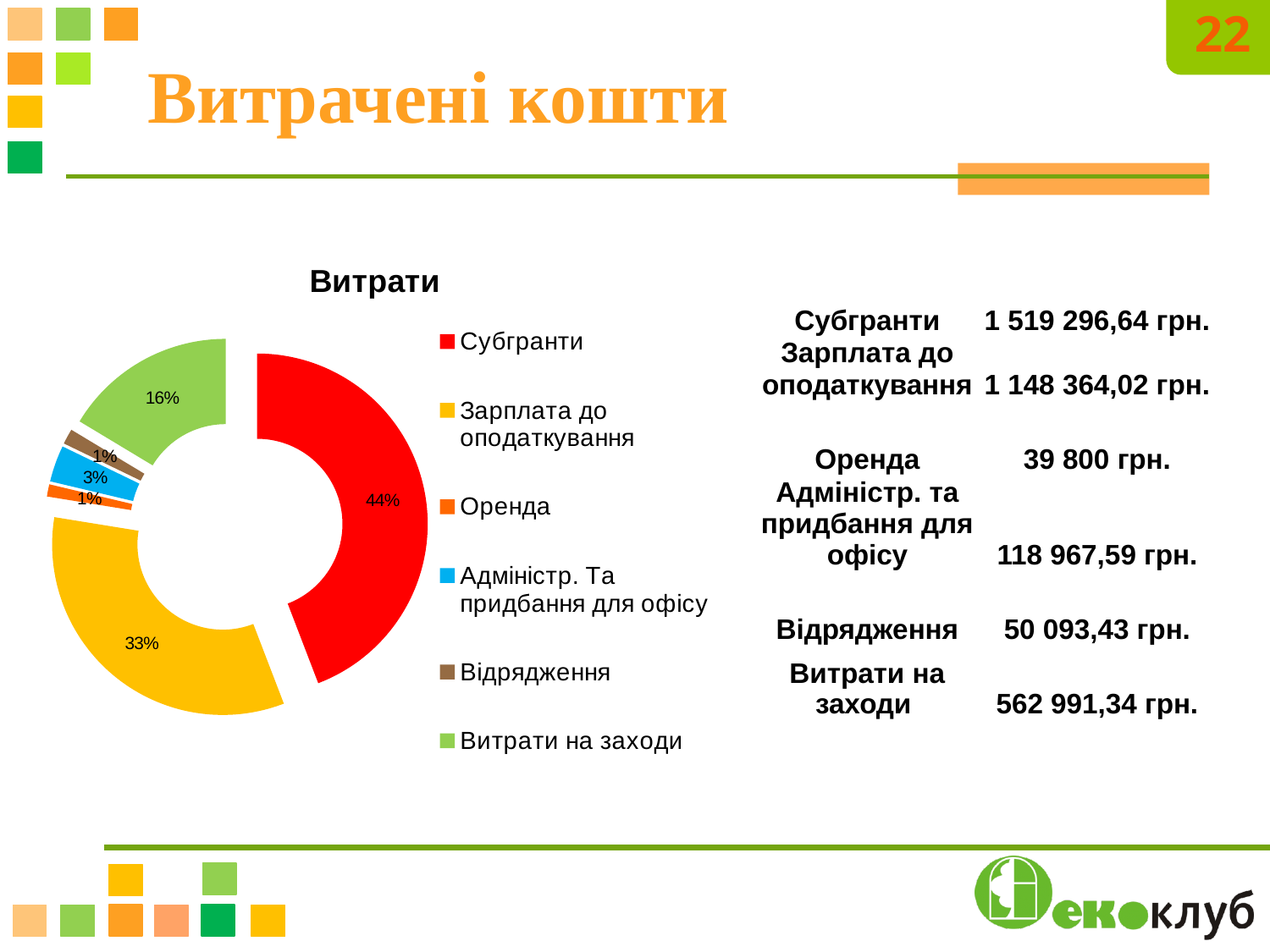
Which category has the largest share of the chart? Субгранти What is the difference in percentage points between Субгранти and Зарплата до оподаткування? 11 What is the chart's title? Витрати What share of the chart does Оренда take? 1% Which has the larger share, Витрати на заходи or Адміністр. Та придбання для офісу? Витрати на заходи What share of the chart does Адміністр. Та придбання для офісу take? 3% How many categories does the legend of the chart list? 6 What share of the chart does Зарплата до оподаткування take? 33% How many slices does the doughnut chart have? 6 What kind of chart is shown on the slide? doughnut chart